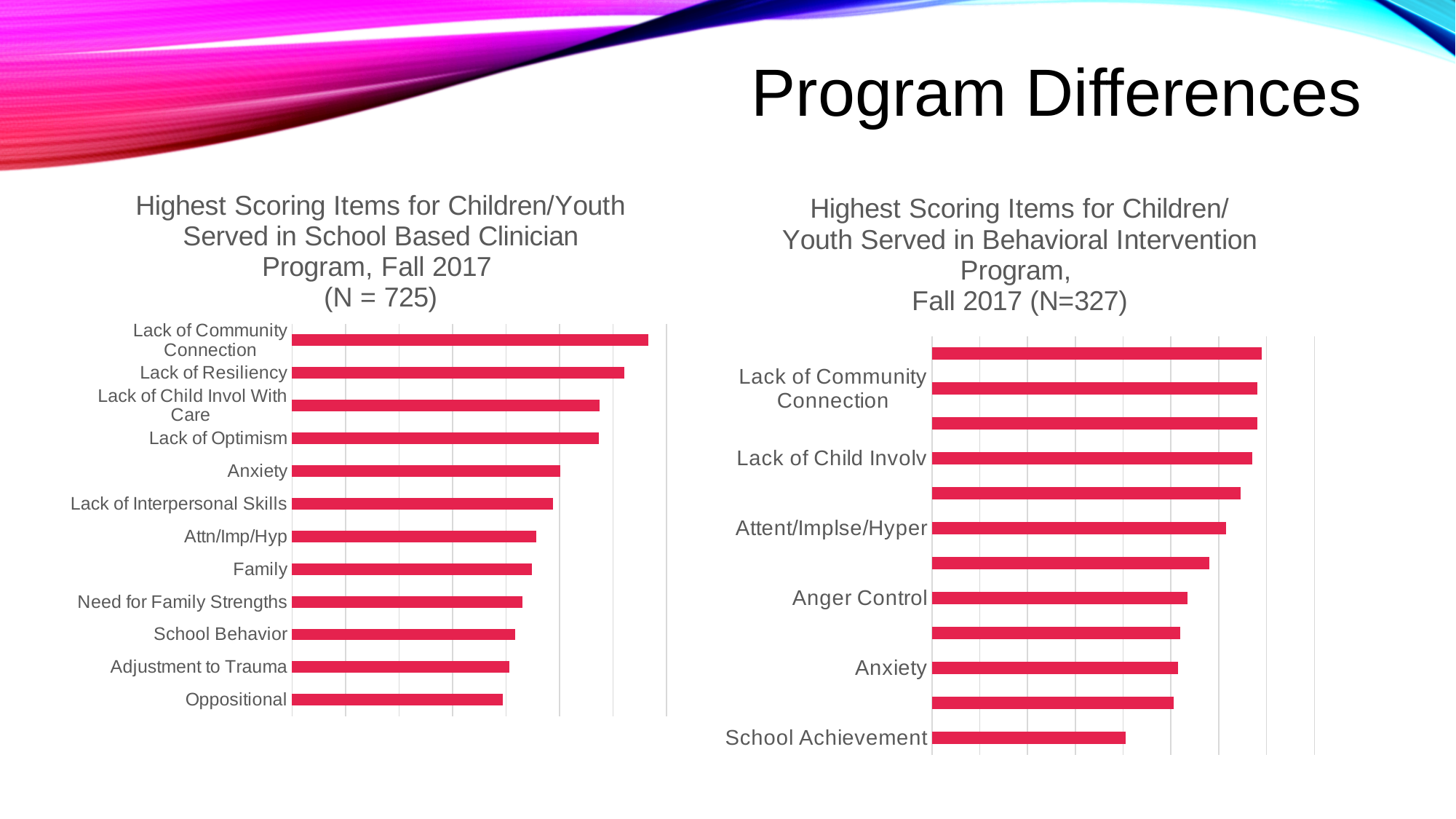
In the right chart (Behavioral Intervention Program), which has the larger value, Lack of Child Involv or School Achievement? Lack of Child Involv In the left chart (School Based Clinician Program), which has the larger value, Lack of Resiliency or Lack of Optimism? Lack of Resiliency What sample size (N) is given in the title of the right chart (Behavioral Intervention Program)? N=327 How many categories are plotted in the left chart (School Based Clinician Program)? 12 What sample size (N) is given in the title of the left chart (School Based Clinician Program)? N = 725 What kind of chart is the left chart, titled "Highest Scoring Items for Children/Youth Served in School Based Clinician Program, Fall 2017"? Bar chart In the left chart (School Based Clinician Program), which item has the lowest score? Oppositional How many bars are plotted in the right chart (Behavioral Intervention Program)? 12 In the right chart (Behavioral Intervention Program), which labeled item has the lowest score? School Achievement In the left chart (School Based Clinician Program), which item has the highest score? Lack of Community Connection In the right chart (Behavioral Intervention Program), which has the larger value, Attent/Implse/Hyper or Anger Control? Attent/Implse/Hyper